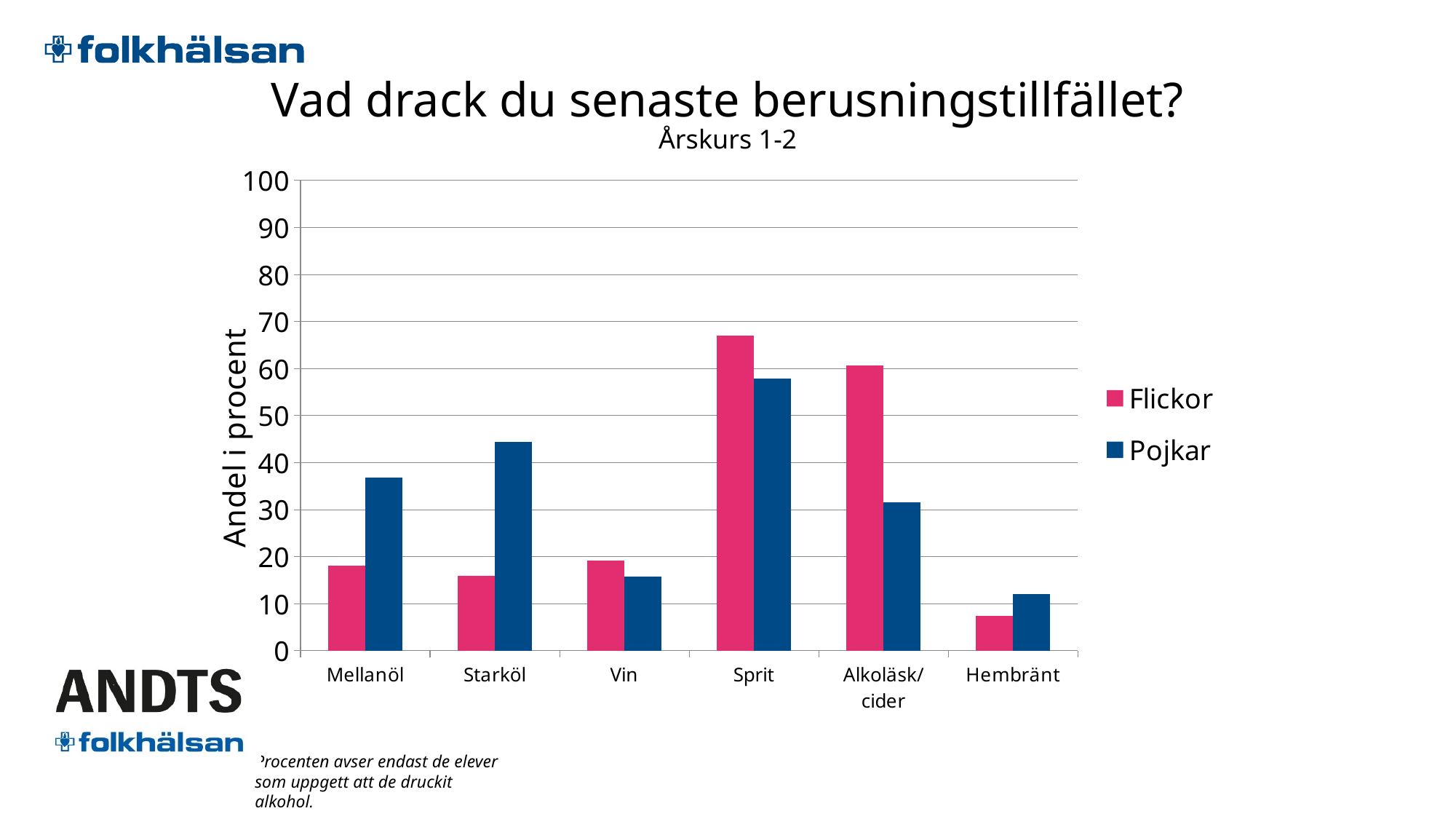
Which category has the highest value for Flickor? Sprit Which category has the lowest value for Pojkar? Hembränt Which category has the highest value for Pojkar? Sprit Is the value for Pojkar in Starköl greater or less than 40? greater How many series does the legend list? 2 Is the value for Flickor in Mellanöl greater or less than 20? less For Alkoläsk/cider, which series has the larger value, Flickor or Pojkar? Flickor What is the label of the y axis? Andel i procent Is the value for Flickor in Sprit greater or less than 60? greater What kind of chart is shown on the slide? bar chart How many categories are shown on the x axis? 6 For Mellanöl, which series has the larger value, Flickor or Pojkar? Pojkar